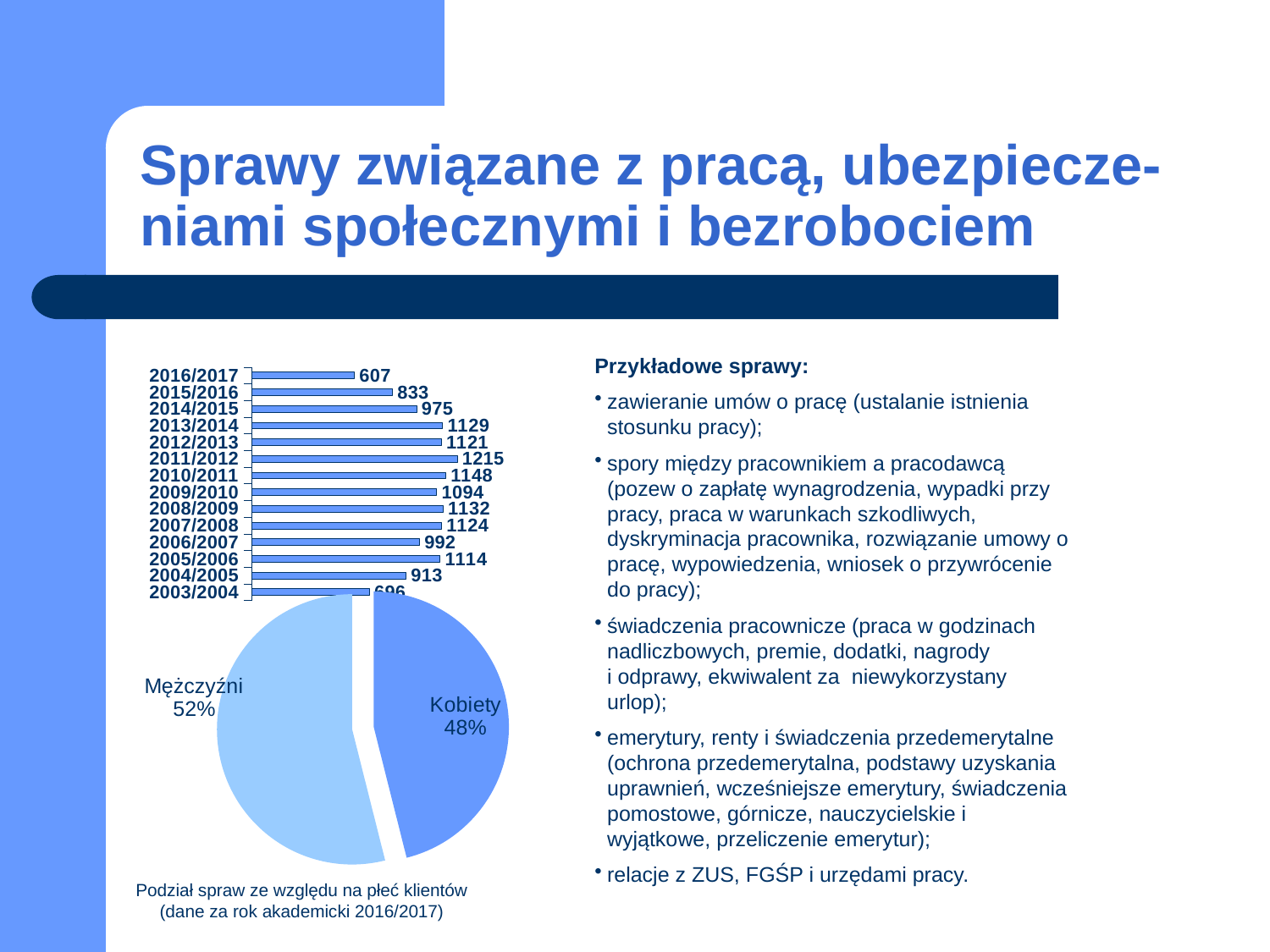
In the bar chart, which year has the highest value? 2011/2012 In the bar chart, what is the difference between the values for 2015/2016 and 2016/2017? 226 In the bar chart, which is larger, the value for 2013/2014 or the value for 2012/2013? 2013/2014 In the pie chart, what share is labelled Kobiety? 48% In the pie chart, which slice is larger, Mężczyźni or Kobiety? Mężczyźni In the bar chart, what is the value for 2016/2017? 607 In the bar chart, what is the value for 2005/2006? 1114 What kind of chart is the chart at the top left of the slide? bar chart In the bar chart, which year has the lowest value? 2016/2017 In the pie chart, what share is labelled Mężczyźni? 52% In the bar chart, how many years are shown? 14 In the bar chart, what is the value for 2011/2012? 1215